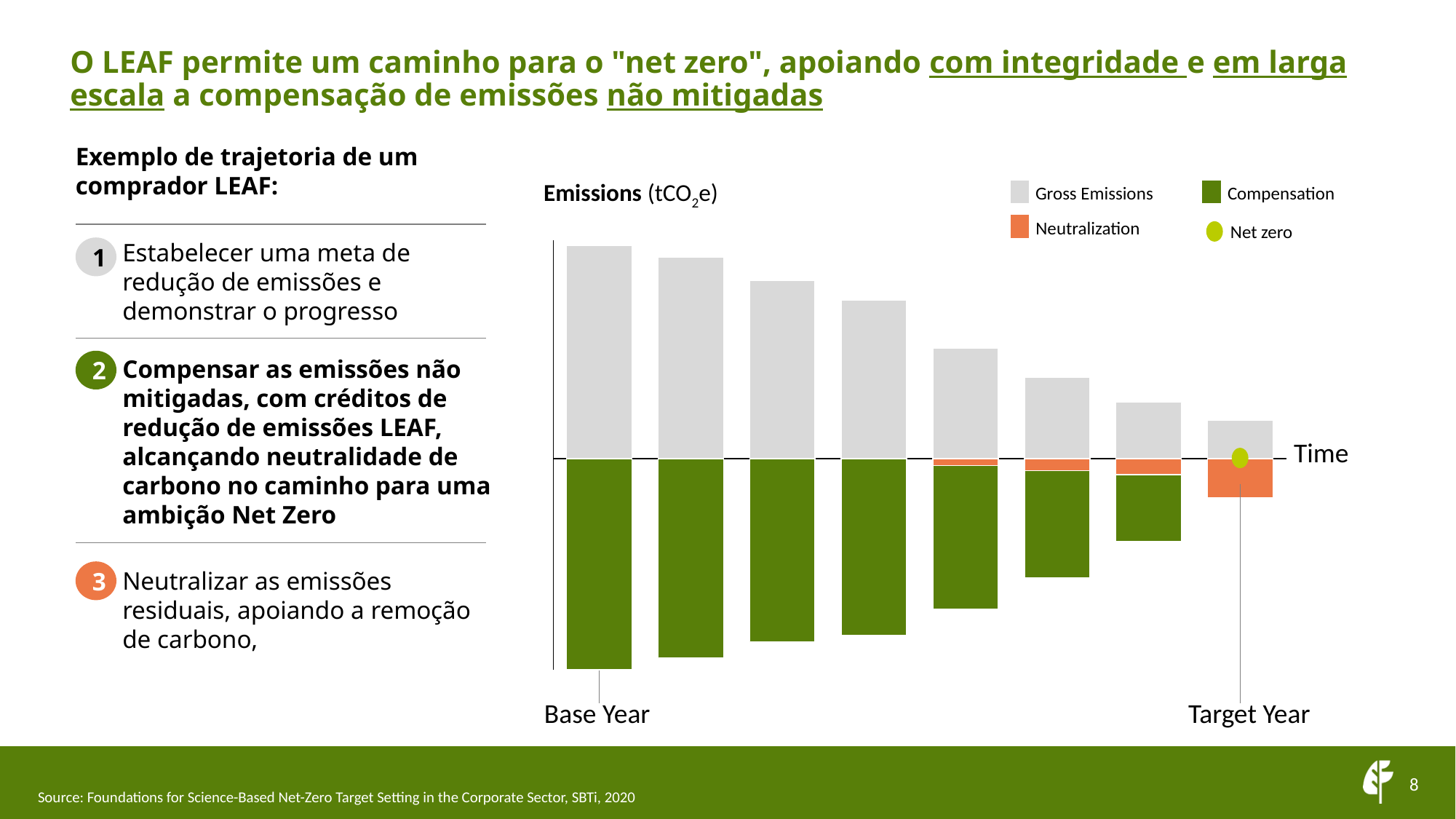
Which bar has the largest Neutralization segment? Target Year Do gross emissions rise or fall from the Base Year to the Target Year? Fall Are gross emissions larger in the Base Year or in the Target Year? Base Year Does the Compensation segment grow or shrink from the Base Year toward the Target Year? Shrink Which legend entry is shown in orange? Neutralization Which bar has the lowest gross emissions? Target Year What kind of chart is shown on the slide? Bar chart What unit is given for the Emissions axis? tCO2e How many series does the chart legend list? 4 How many bars are plotted along the time axis? 8 Which bar has no Compensation segment? Target Year Which bar has the highest gross emissions? Base Year